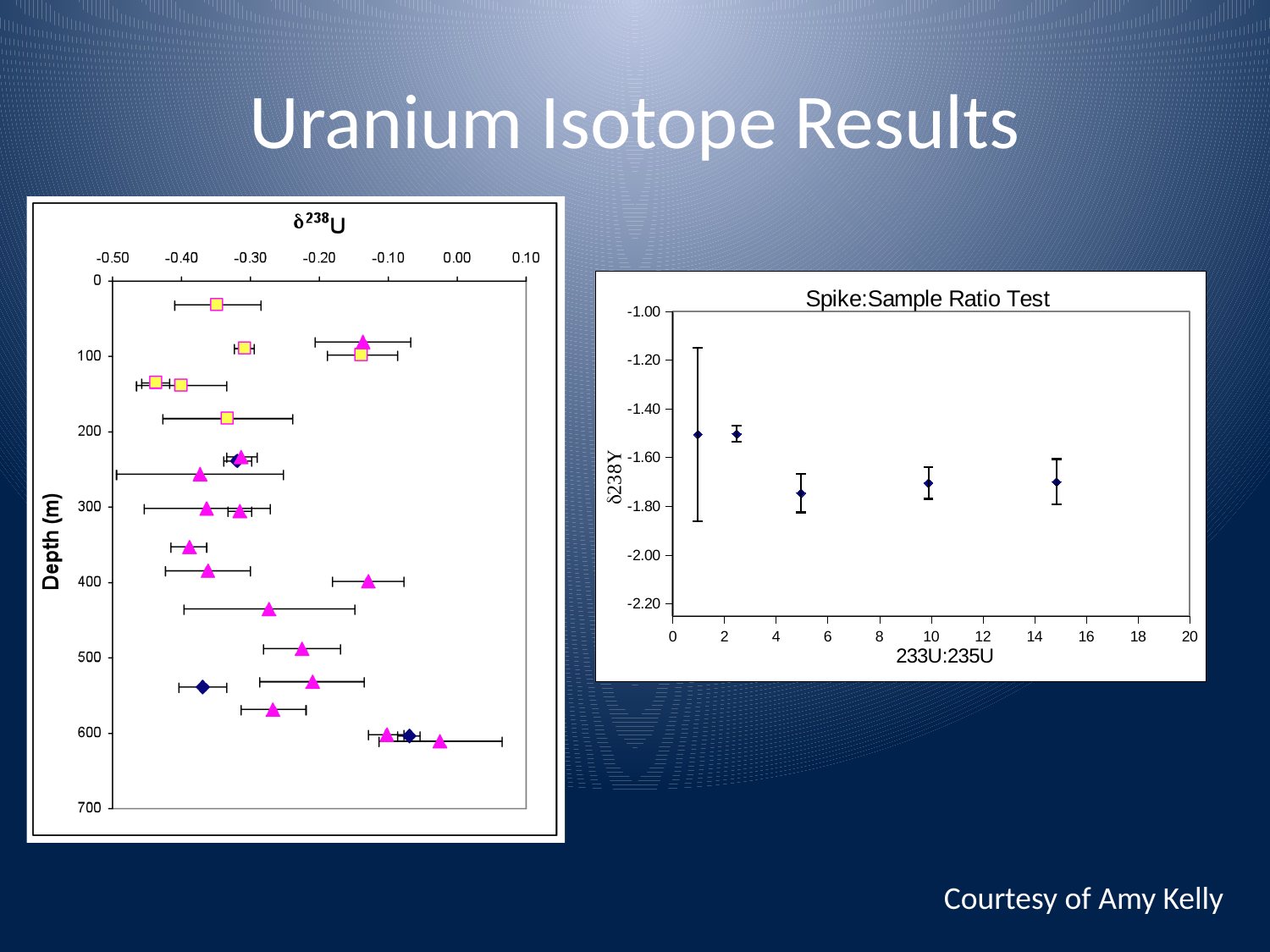
What kind of chart is the left chart showing δ238U against Depth (m)? Scatter chart In the Spike:Sample Ratio Test chart, is the δ238Y value for the point at a 233U:235U ratio of about 5 greater or less than -1.60? less In the Spike:Sample Ratio Test chart, is the δ238Y value for the point at a 233U:235U ratio of about 1 greater or less than -1.60? greater What kind of chart is the Spike:Sample Ratio Test chart? Scatter chart In the left chart of δ238U against Depth (m), is the δ238U value of the deepest point (at about 610 m) greater or less than -0.10? greater In the Spike:Sample Ratio Test chart, what is the label of the x axis? 233U:235U What is the title of the chart on the right side of the slide? Spike:Sample Ratio Test How many charts are shown on the slide? 2 In the Spike:Sample Ratio Test chart, how many data points are plotted? 5 In the left chart of δ238U against Depth (m), how many blue diamond markers are plotted? 3